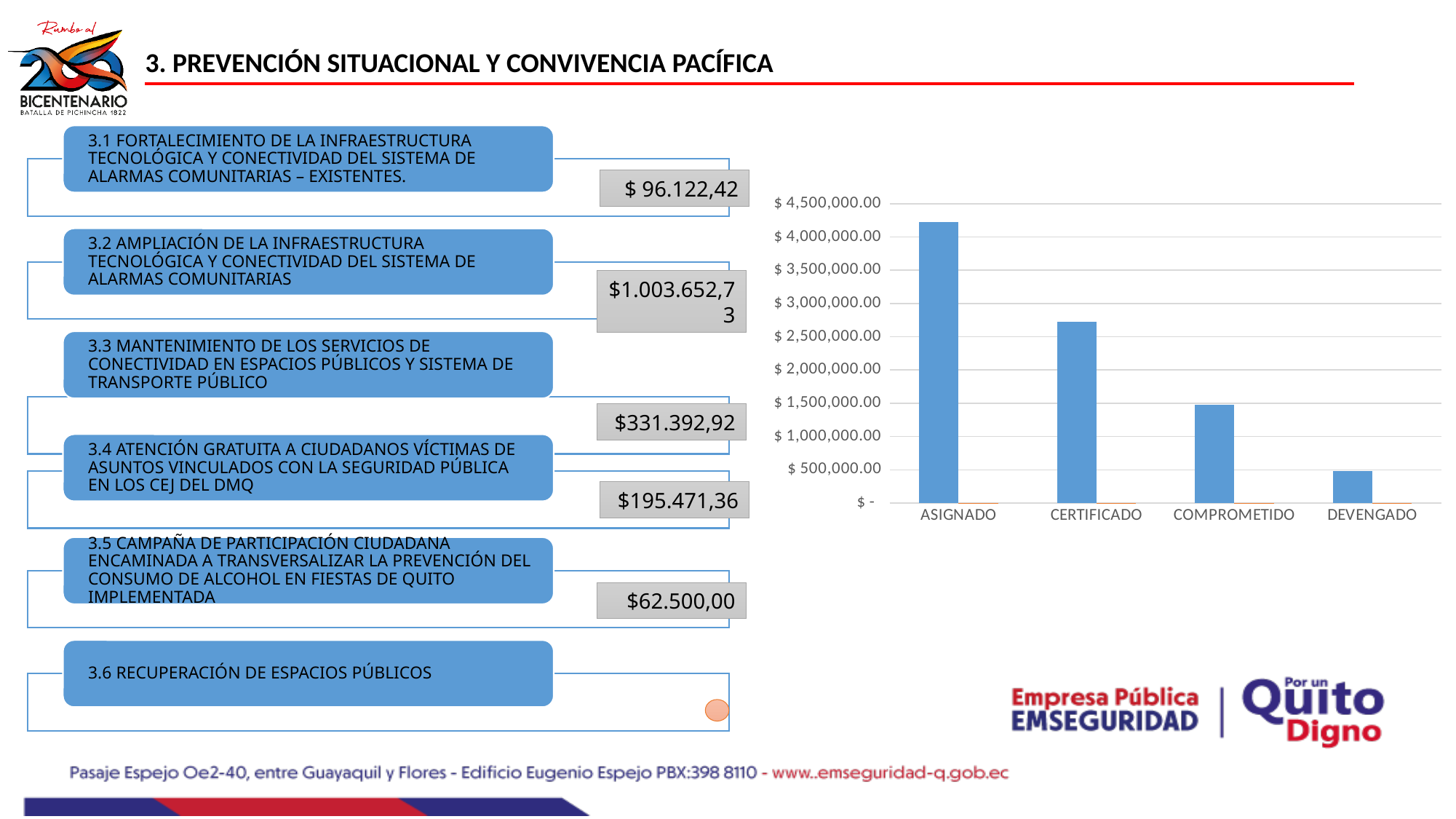
Which is larger, the value for CERTIFICADO or the value for COMPROMETIDO? CERTIFICADO What is the highest tick value shown on the chart's vertical axis? $ 4,500,000.00 Is the value for CERTIFICADO greater or less than $ 3,000,000.00? less What kind of chart is shown on the slide? bar chart Is the value for COMPROMETIDO greater or less than $ 1,000,000.00? greater Which category has the highest value in the chart? ASIGNADO How many categories are plotted on the x axis of the chart? 4 Which category has the lowest value in the chart? DEVENGADO Is the value for ASIGNADO greater or less than $ 4,000,000.00? greater Which is larger, the value for COMPROMETIDO or the value for DEVENGADO? COMPROMETIDO Do the bar values rise or fall from left to right along the x axis? fall